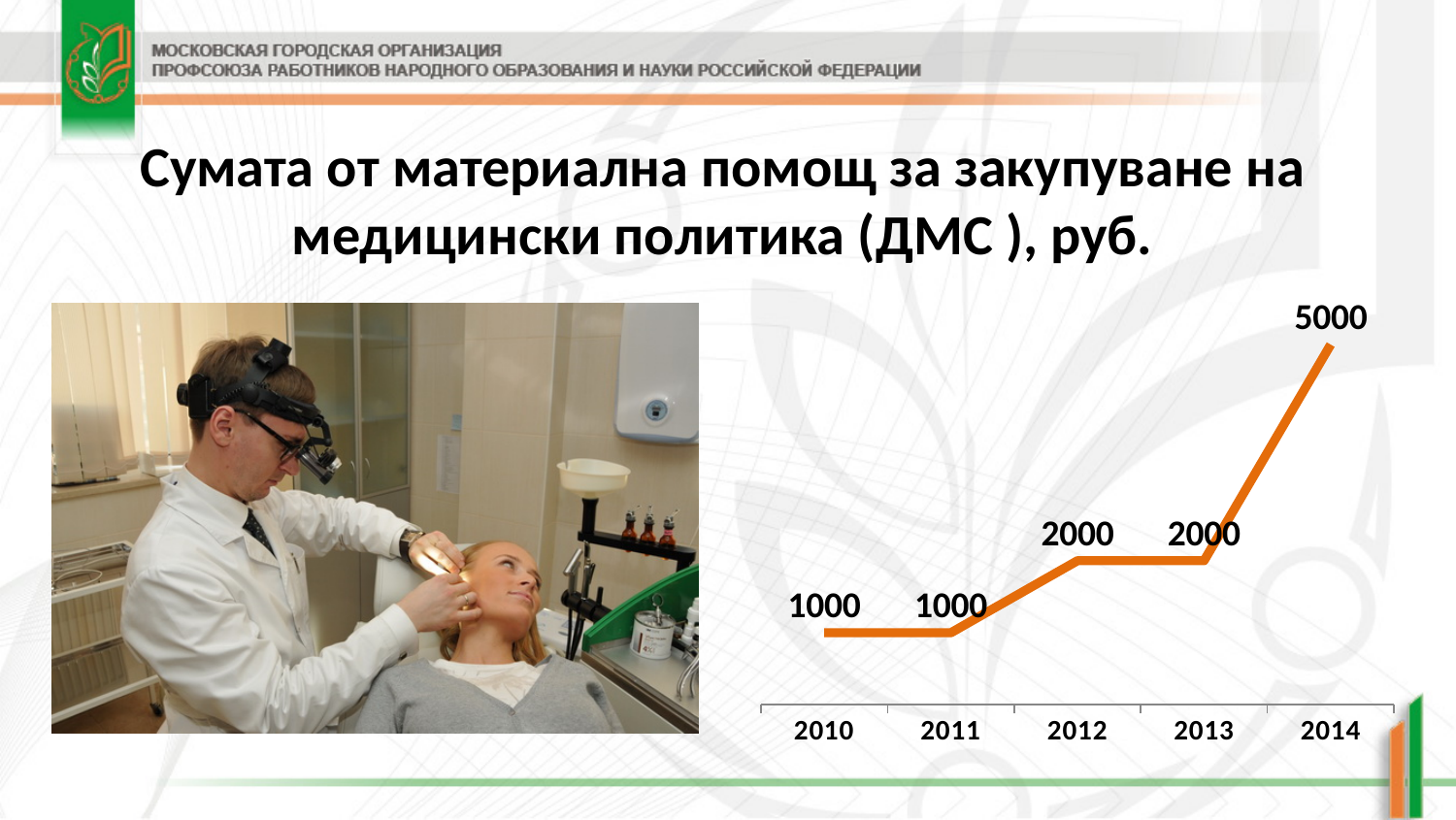
What is the difference between the values for 2014 and 2013? 3000 Which is larger, the value for 2013 or the value for 2011? 2013 What kind of chart is shown on the slide? line chart Do the values rise or fall from 2010 to 2014? rise Are the values for 2010 and 2011 the same or different? the same What is the value for 2014? 5000 Which year has the highest value? 2014 What is the difference between the values for 2012 and 2011? 1000 What is the value for 2010? 1000 What colour is the line on the chart? orange How many years are plotted on the chart? 5 What is the value for 2012? 2000